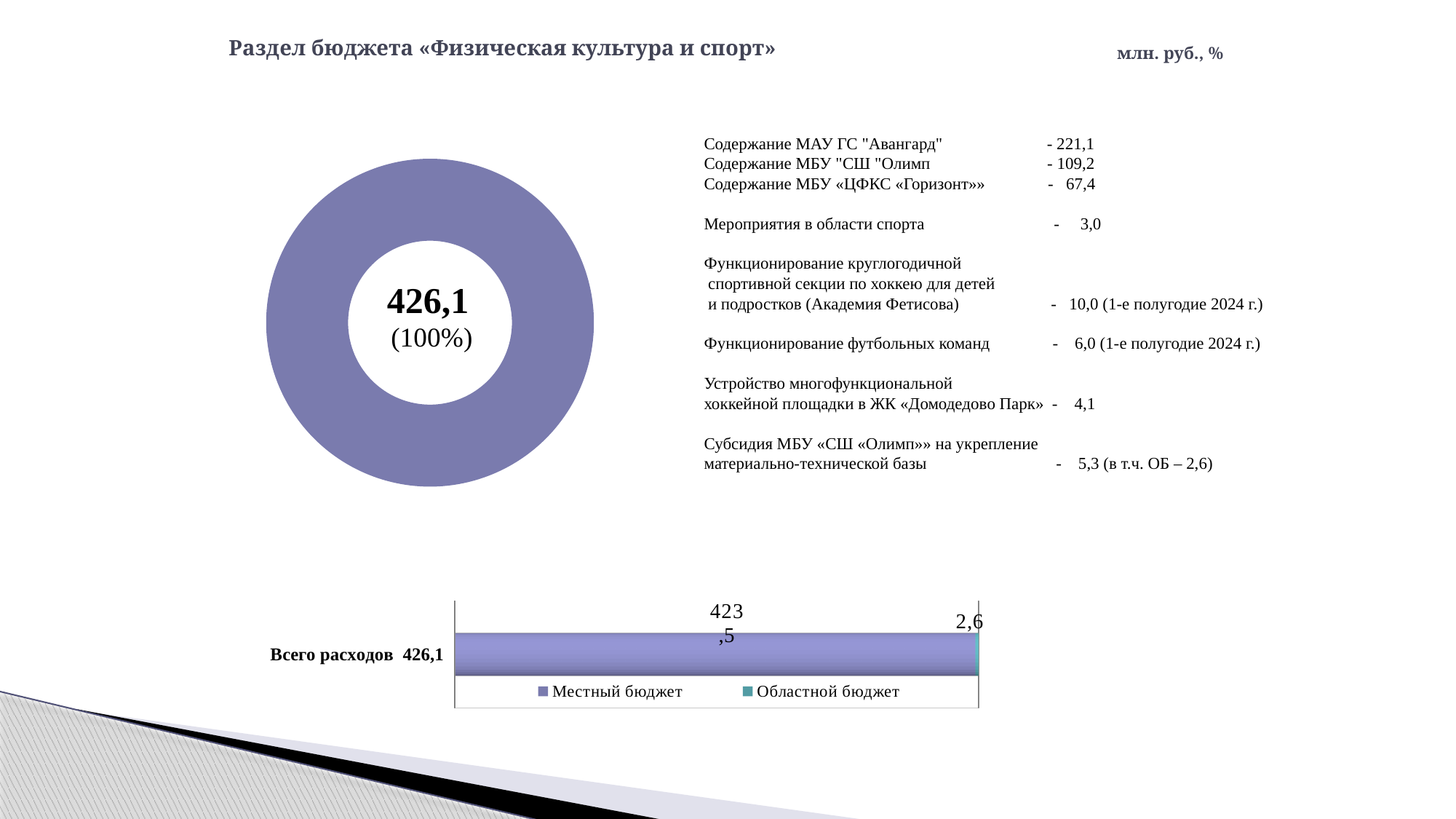
What kind of chart is the chart at the top left of the slide? Doughnut chart In the bar chart at the bottom, what is the total of the stacked bar for Всего расходов? 426,1 In the bar chart at the bottom, what are the two legend entries? Местный бюджет, Областной бюджет In the bar chart at the bottom, what is the value for Областной бюджет? 2,6 In the bar chart at the bottom, how many series does the legend list? 2 In the bar chart at the bottom, how many categories are plotted? 1 In the doughnut chart at the top left, what value is shown in the centre? 426,1 In the bar chart at the bottom, which series has the larger value, Местный бюджет or Областной бюджет? Местный бюджет In the doughnut chart at the top left, what percentage share is shown for the single slice? 100% In the bar chart at the bottom, what is the value for Местный бюджет? 423,5 What kind of chart is the chart at the bottom of the slide? Bar chart In the bar chart at the bottom, what is the difference between the Местный бюджет value and the Областной бюджет value? 420,9